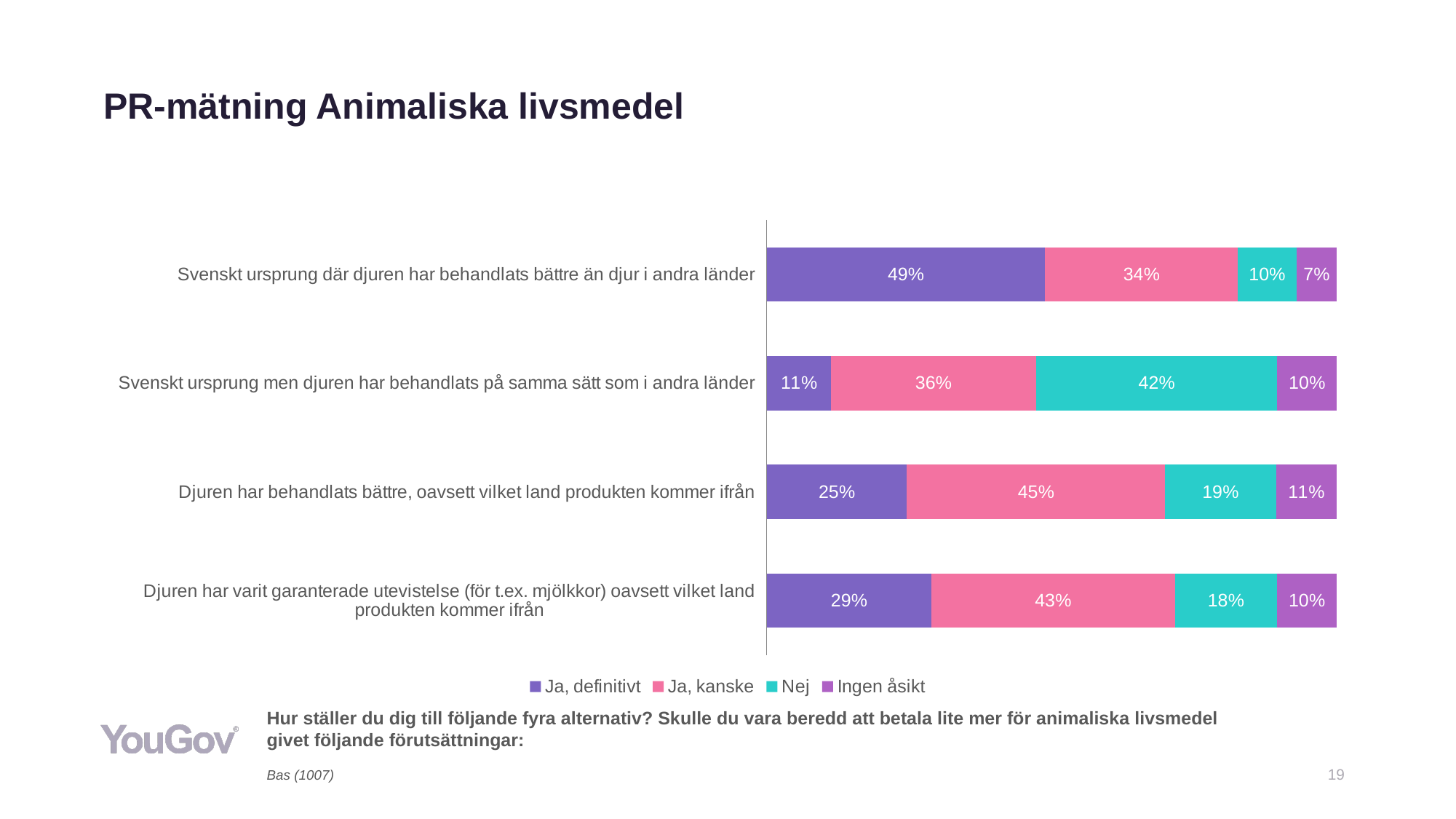
Which category has the highest "Ja, definitivt" share? Svenskt ursprung där djuren har behandlats bättre än djur i andra länder What percentage answered "Ingen åsikt" for "Djuren har varit garanterade utevistelse (för t.ex. mjölkkor) oavsett vilket land produkten kommer ifrån"? 10% How many series does the legend list? 4 What percentage answered "Ja, definitivt" for "Svenskt ursprung där djuren har behandlats bättre än djur i andra länder"? 49% What is the difference between the "Nej" share for "Svenskt ursprung men djuren har behandlats på samma sätt som i andra länder" and the "Nej" share for "Svenskt ursprung där djuren har behandlats bättre än djur i andra länder"? 32 percentage points What kind of chart is shown on the slide? Stacked bar chart Which category has the lowest "Ja, definitivt" share? Svenskt ursprung men djuren har behandlats på samma sätt som i andra länder What percentage answered "Nej" for "Svenskt ursprung men djuren har behandlats på samma sätt som i andra länder"? 42% What is the combined share of "Ja, definitivt" and "Ja, kanske" for "Svenskt ursprung där djuren har behandlats bättre än djur i andra länder"? 83% How many categories (bars) does the chart show? 4 Which is larger: the "Ja, kanske" share for "Djuren har behandlats bättre, oavsett vilket land produkten kommer ifrån" or for "Djuren har varit garanterade utevistelse (för t.ex. mjölkkor) oavsett vilket land produkten kommer ifrån"? Djuren har behandlats bättre, oavsett vilket land produkten kommer ifrån What percentage answered "Ja, kanske" for "Djuren har behandlats bättre, oavsett vilket land produkten kommer ifrån"? 45%